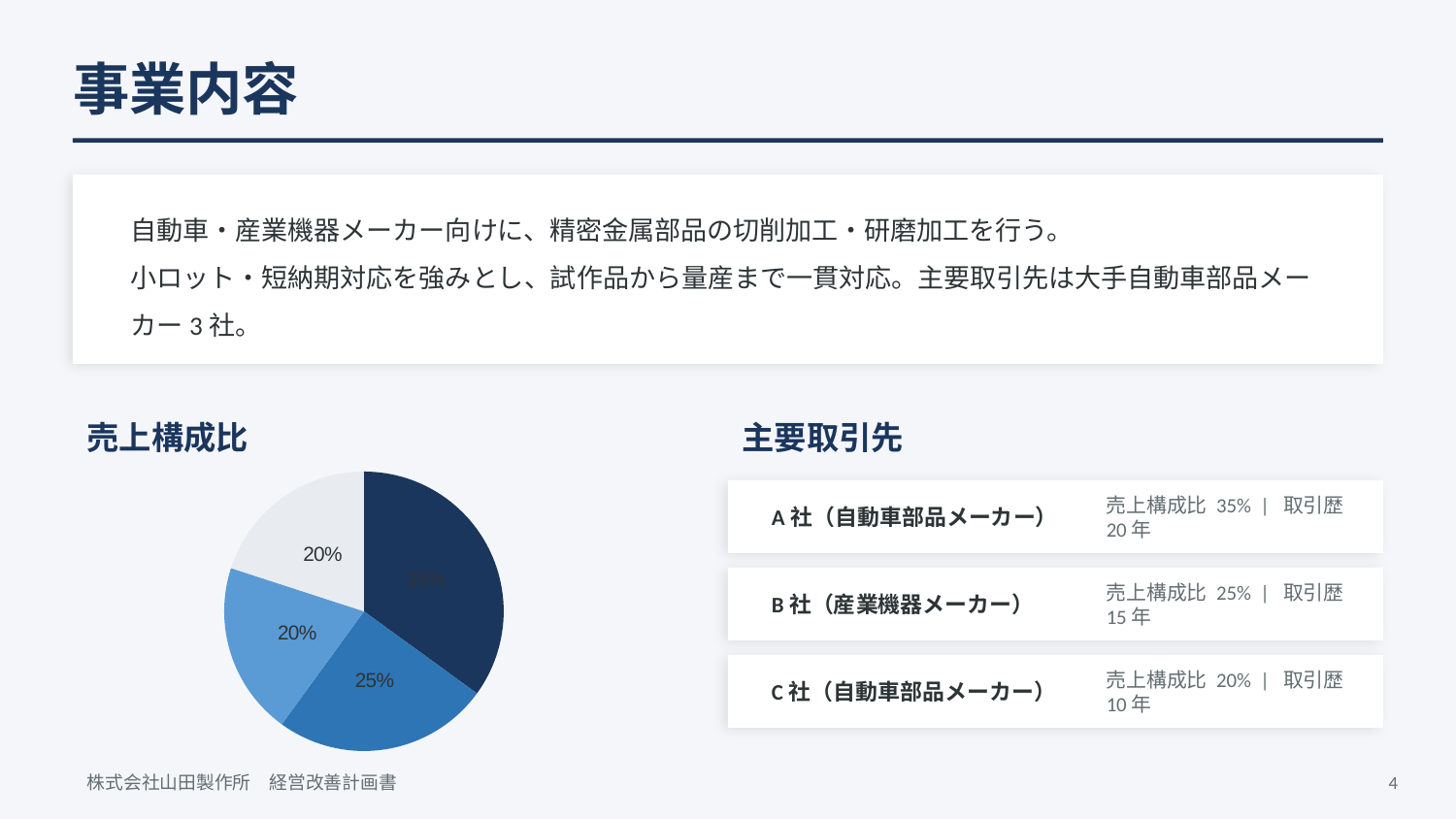
In the 売上構成比 pie chart, what is the difference between the 25% slice and the light-blue 20% slice? 5% In the 売上構成比 pie chart, which slice is larger: the dark navy slice or the medium-blue slice labelled 25%? The dark navy slice In the 売上構成比 pie chart, is the dark navy slice greater or less than 25%? greater In the 売上構成比 pie chart, what value is printed on the light-blue slice on the left? 20% In the 売上構成比 pie chart, what value is printed on the light-grey slice at the top left? 20% In the 売上構成比 pie chart, how many slices are labelled 20%? 2 What is the title of the pie chart on the slide? 売上構成比 How many slices does the 売上構成比 pie chart have? 4 What kind of chart is shown under the heading 売上構成比? Pie chart In the 売上構成比 pie chart, which slice is the largest? The dark navy slice In the 売上構成比 pie chart, what value is printed on the medium-blue slice at the bottom? 25%